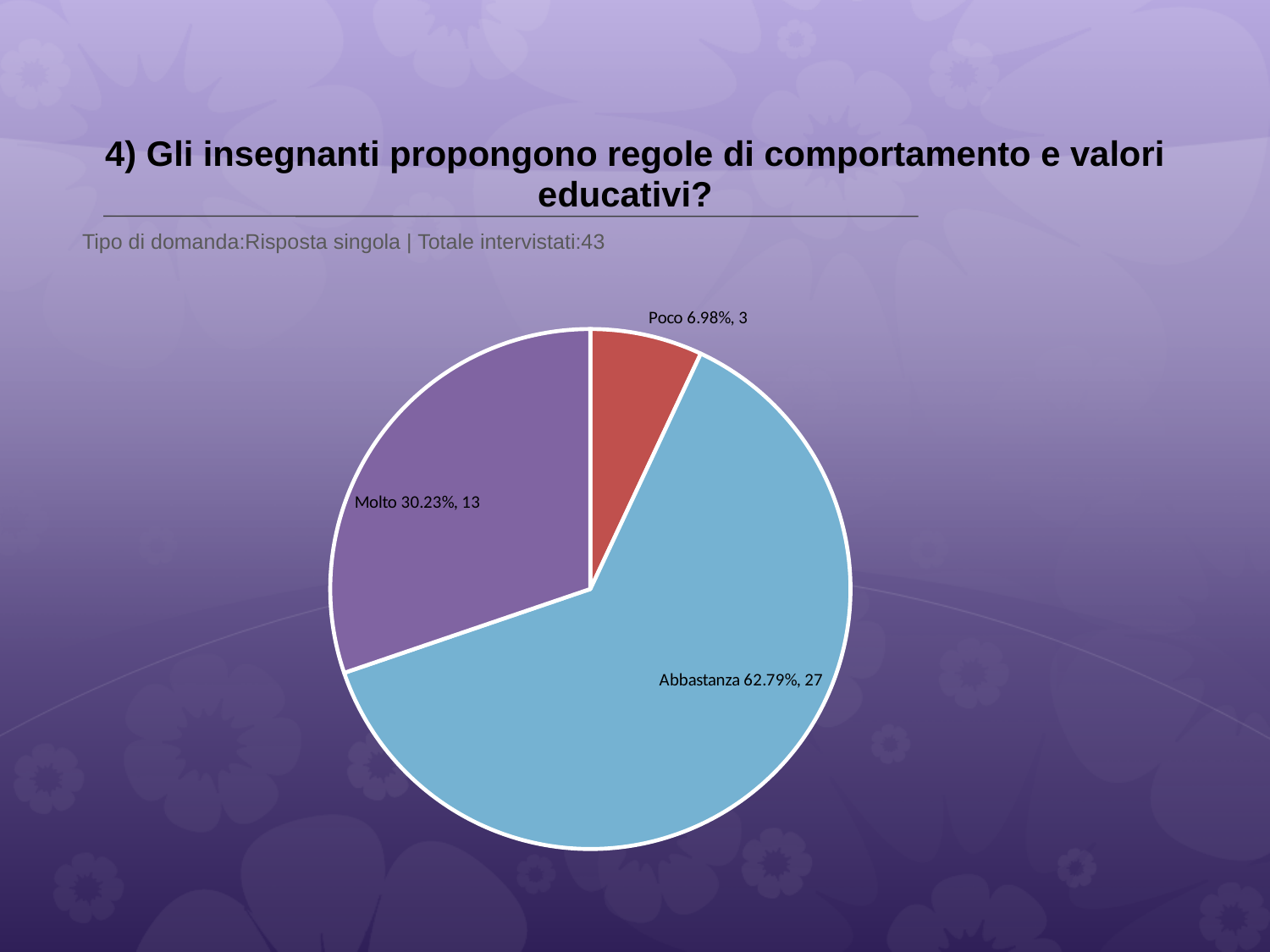
How many slices does the pie chart have? 3 What percentage share does the 'Abbastanza' slice have? 62.79% How many respondents answered 'Molto'? 13 Which category has the smallest slice? Poco Which category has the largest slice? Abbastanza What is the difference in respondent count between 'Abbastanza' and 'Molto'? 14 What percentage share does the 'Poco' slice have? 6.98% What kind of chart is shown on the slide? pie chart What percentage share does the 'Molto' slice have? 30.23% How many respondents answered 'Poco'? 3 Which has more respondents, 'Molto' or 'Poco'? Molto How many respondents answered 'Abbastanza'? 27